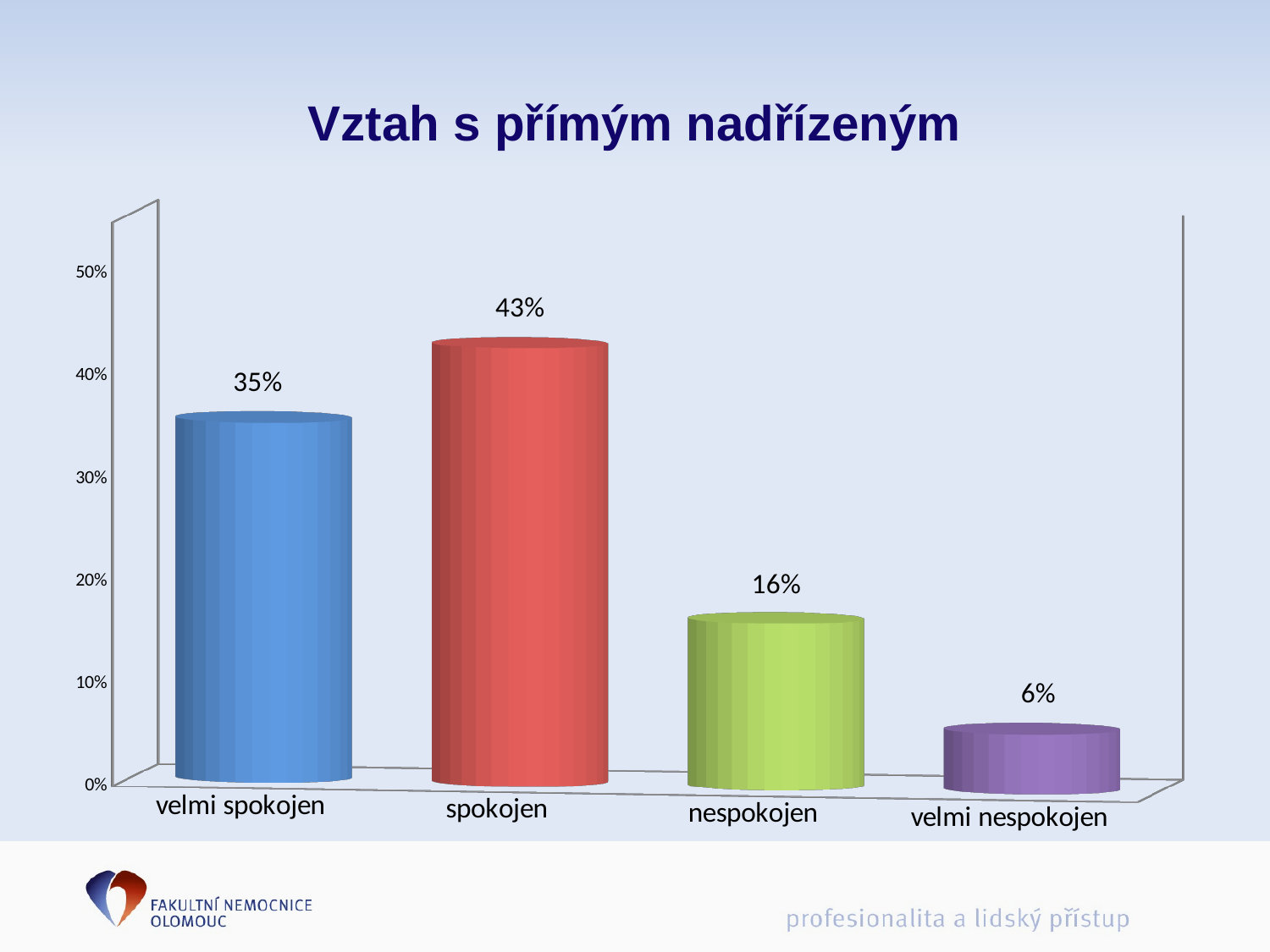
What is the difference between the values for "spokojen" and "velmi spokojen"? 8% What is the value for "velmi spokojen"? 35% What is the value for "nespokojen"? 16% What kind of chart is shown on the slide? bar chart What is the value for "spokojen"? 43% Which category has the highest value? spokojen Which is larger, the value for "velmi spokojen" or the value for "nespokojen"? velmi spokojen Which category has the lowest value? velmi nespokojen What is the difference between the values for "nespokojen" and "velmi nespokojen"? 10% What is the title of the chart? Vztah s přímým nadřízeným How many categories are shown on the x axis? 4 What is the value for "velmi nespokojen"? 6%